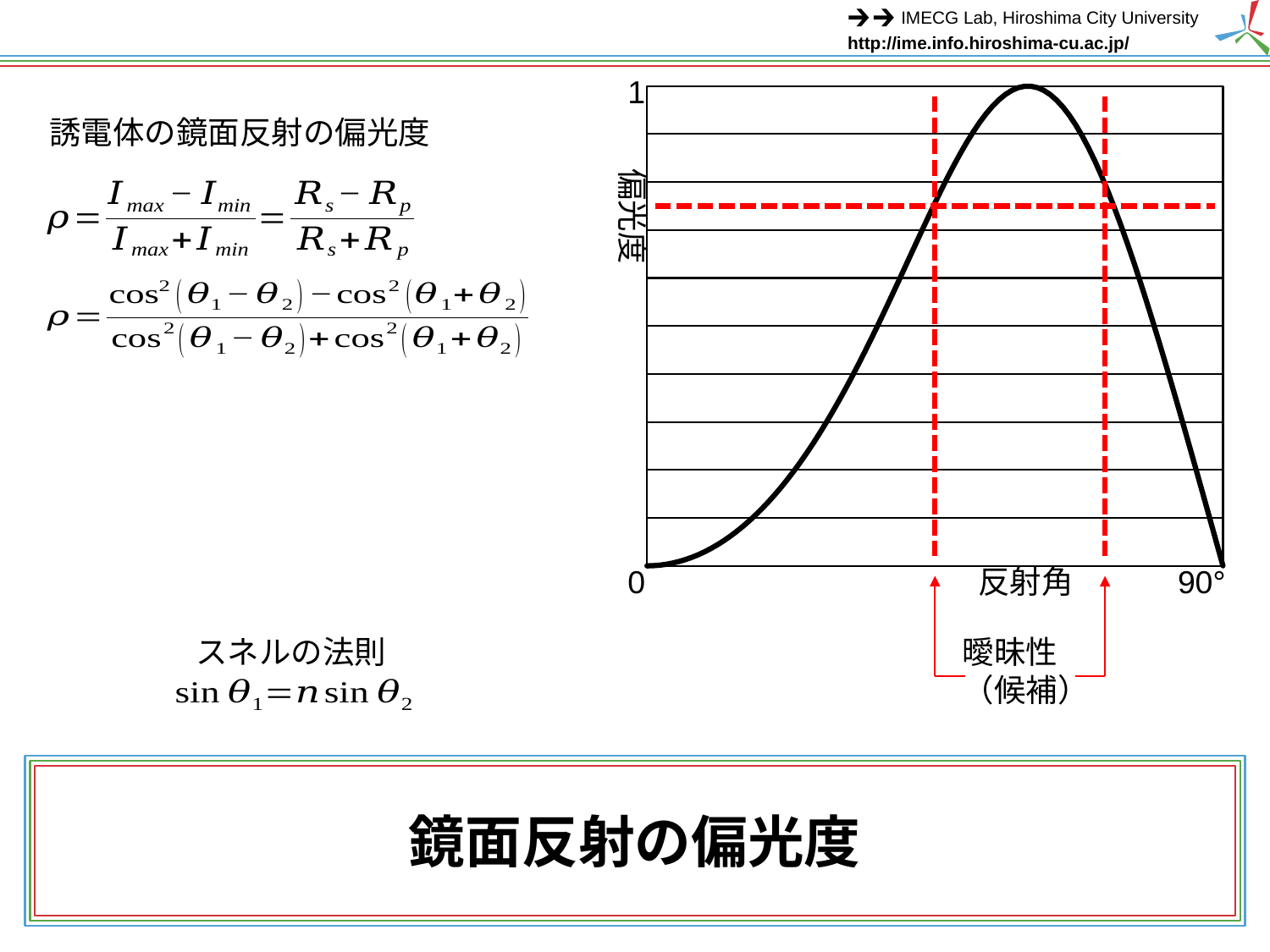
Does the curve rise or fall as the reflection angle increases from its peak toward 90°? fall What is the label of the y axis of the chart? 偏光度 What kind of chart is shown on the right side of the slide? line chart What is the largest value shown on the x axis of the chart? 90° What is the highest value shown on the y axis of the chart? 1 What is the value of the curve at a reflection angle of 0? 0 What is the label of the x axis of the chart? 反射角 What is the maximum value reached by the curve? 1 What label is given to the two red dashed vertical lines below the chart? 曖昧性（候補） What is the value of the curve at a reflection angle of 90°? 0 Does the curve rise or fall as the reflection angle increases from 0 toward its peak? rise How many red dashed vertical lines (candidate angles) are marked on the chart? 2